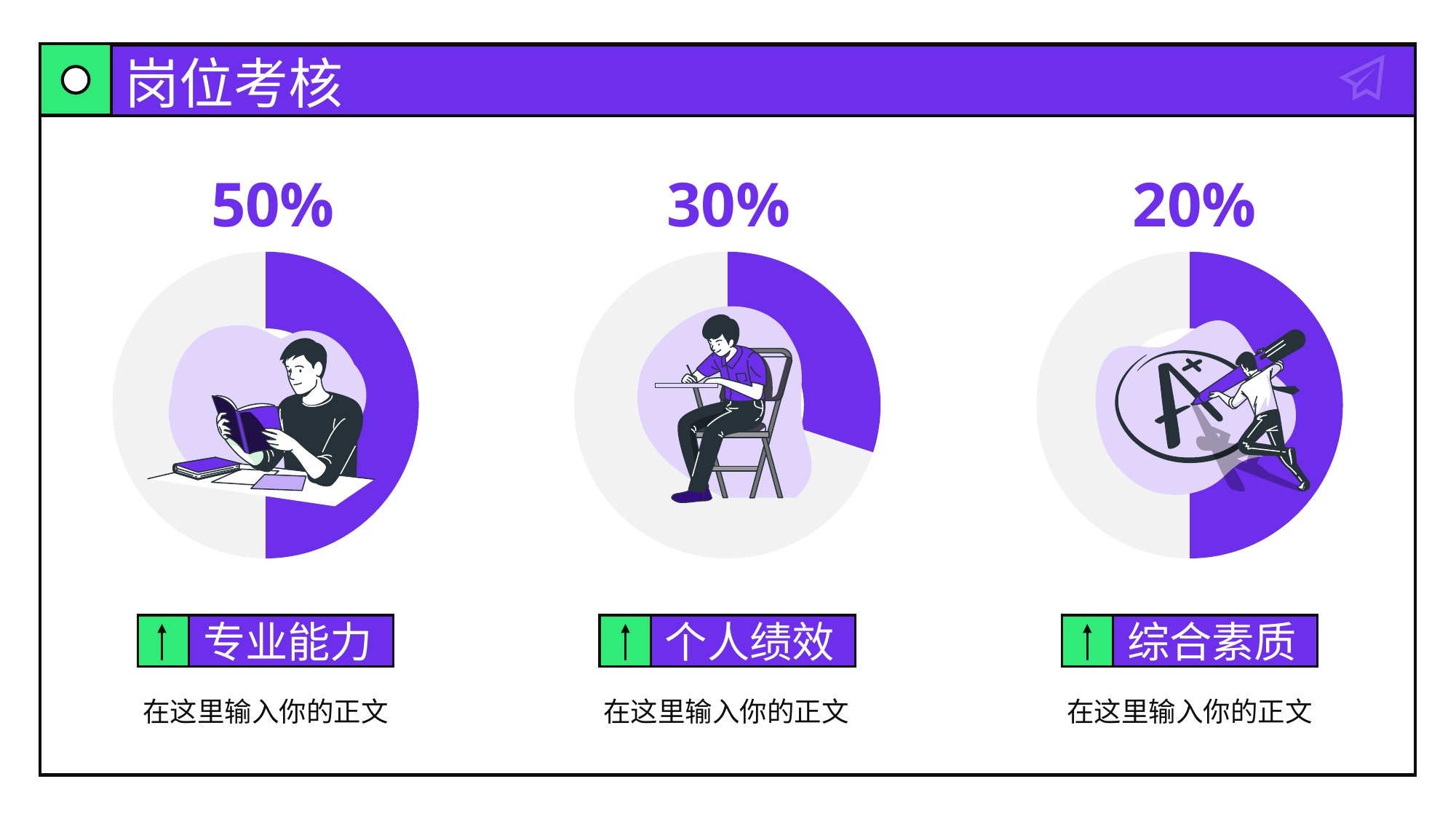
What percentage is shown for 综合素质? 20% What is the difference between the percentages for 专业能力 and 个人绩效? 20% What is the title of the slide? 岗位考核 What is the total of the three percentages shown on the slide? 100% Which of the three categories has the lowest percentage? 综合素质 Which is larger, the percentage for 个人绩效 or for 综合素质? 个人绩效 What percentage is shown for 个人绩效? 30% What kind of chart is used for each of the three categories? Doughnut chart How many circular charts are shown on the slide? 3 Which of the three categories has the highest percentage? 专业能力 What percentage is shown for 专业能力? 50% What is the difference between the percentages for 个人绩效 and 综合素质? 10%